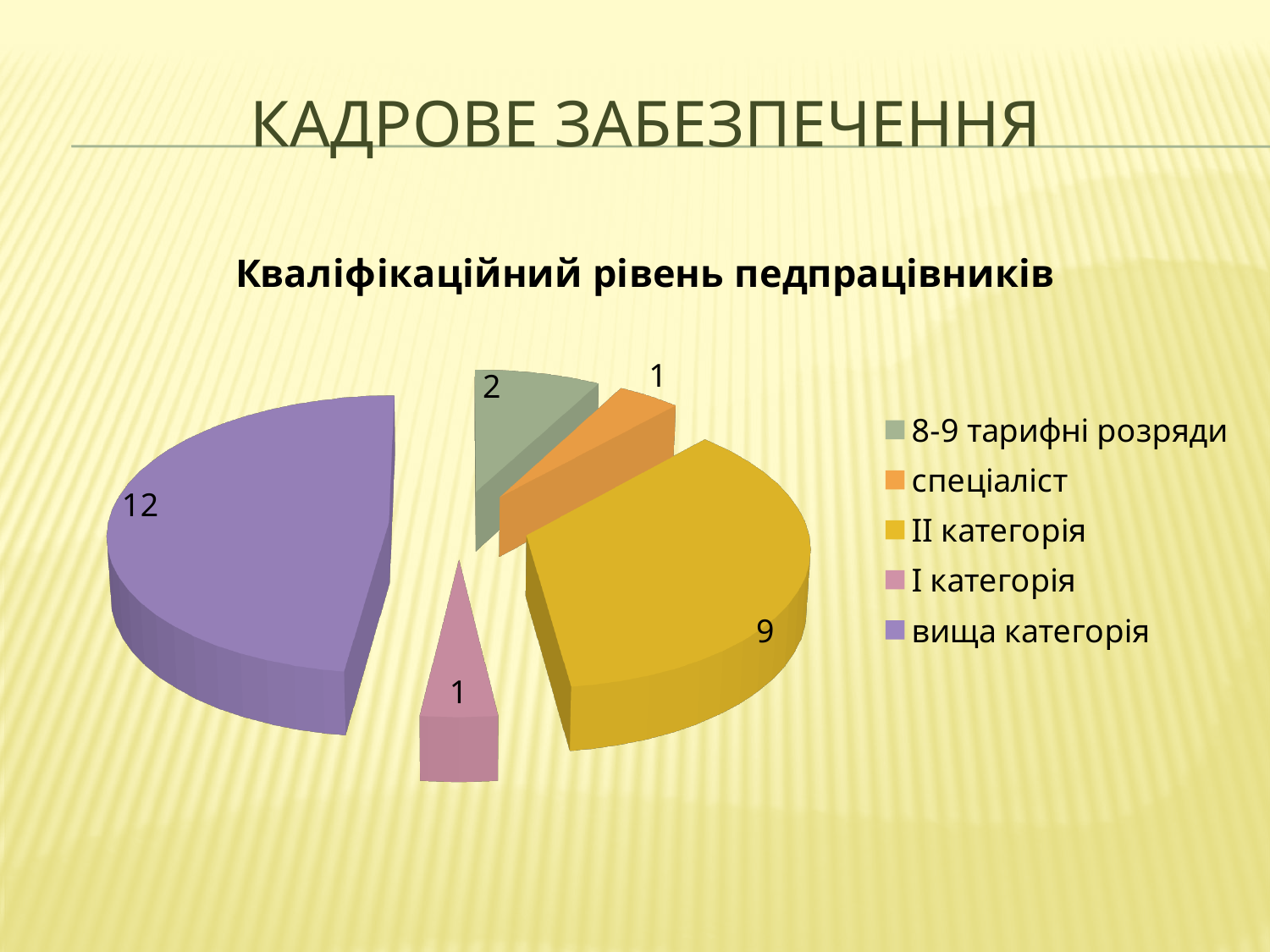
Which category has the largest slice? вища категорія What is the title of the chart? Кваліфікаційний рівень педпрацівників What is the value for 8-9 тарифні розряди? 2 What share of the pie does вища категорія represent? 48% Which is larger, the value for 8-9 тарифні розряди or the value for I категорія? 8-9 тарифні розряди What is the total of all the slices in the pie? 25 What is the value for спеціаліст? 1 What type of chart is shown on the slide? pie chart What is the value for вища категорія? 12 How many categories does the legend list? 5 What is the value for II категорія? 9 What is the difference between the values for вища категорія and II категорія? 3